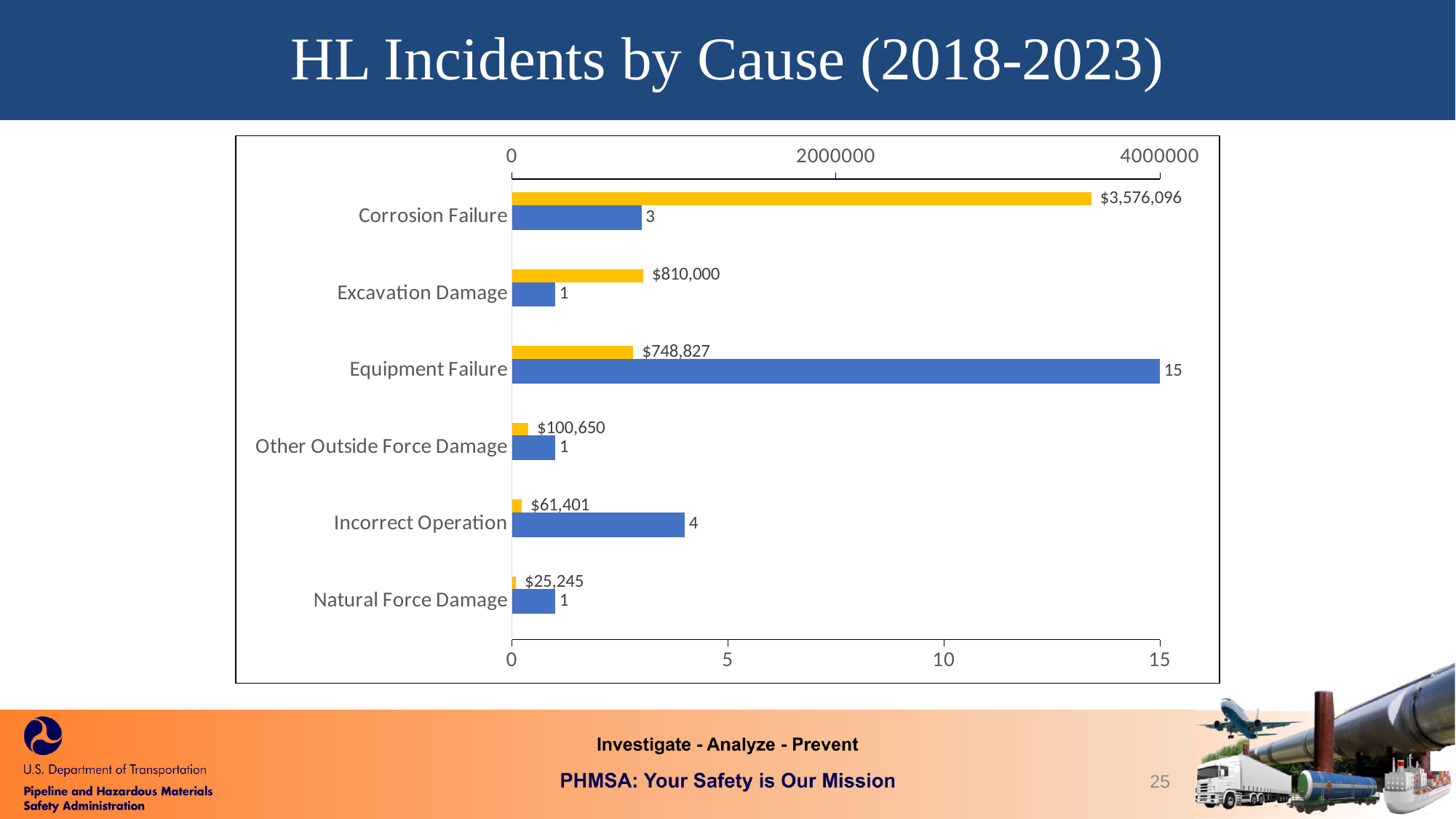
What is the dollar value shown for Excavation Damage? $810,000 What is the count (blue bar) shown for Equipment Failure? 15 Which cause has the lowest dollar value (yellow bar)? Natural Force Damage What is the difference between the dollar values for Excavation Damage and Equipment Failure? $61,173 What is the count (blue bar) shown for Incorrect Operation? 4 What is the dollar value shown for Natural Force Damage? $25,245 Which cause has the highest dollar value (yellow bar)? Corrosion Failure Which has a larger count (blue bar): Corrosion Failure or Incorrect Operation? Incorrect Operation Which cause has the highest count (blue bar)? Equipment Failure What type of chart is shown on the slide? Bar chart How many causes are listed on the chart? 6 What is the dollar value shown for Corrosion Failure? $3,576,096